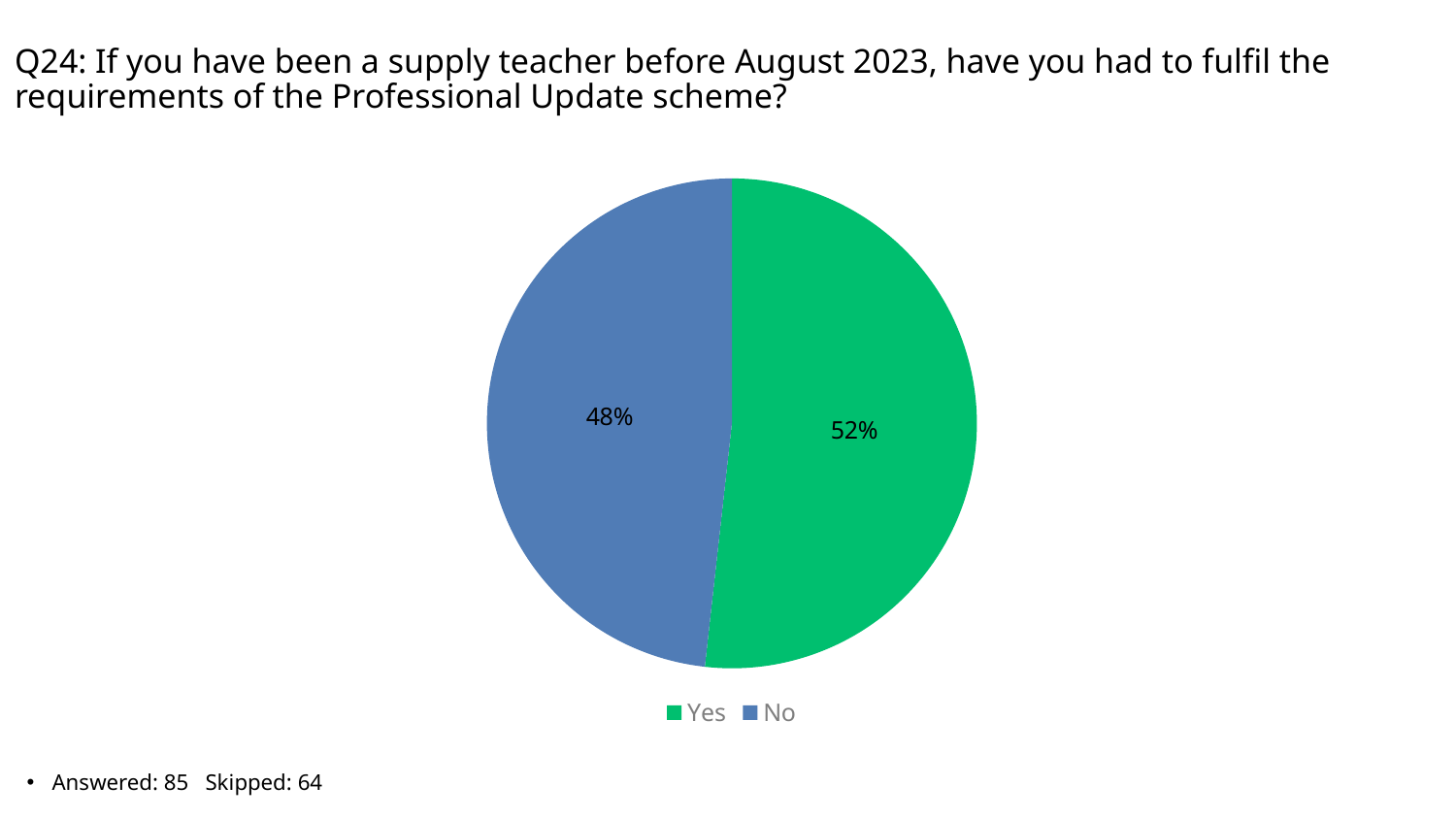
What share of the pie does the No slice represent? 48% Which response has the larger share of the pie? Yes What colour is the Yes slice? green What percentage of respondents answered No? 48% Is the share for Yes larger or smaller than the share for No? larger How many slices does the pie chart have? 2 Which response has the smaller share of the pie? No What kind of chart is shown on the slide? pie chart What is the difference in percentage points between the Yes and No shares? 4 What are the two legend entries for the chart? Yes and No How many respondents answered this question according to the slide? 85 What percentage of respondents answered Yes? 52%